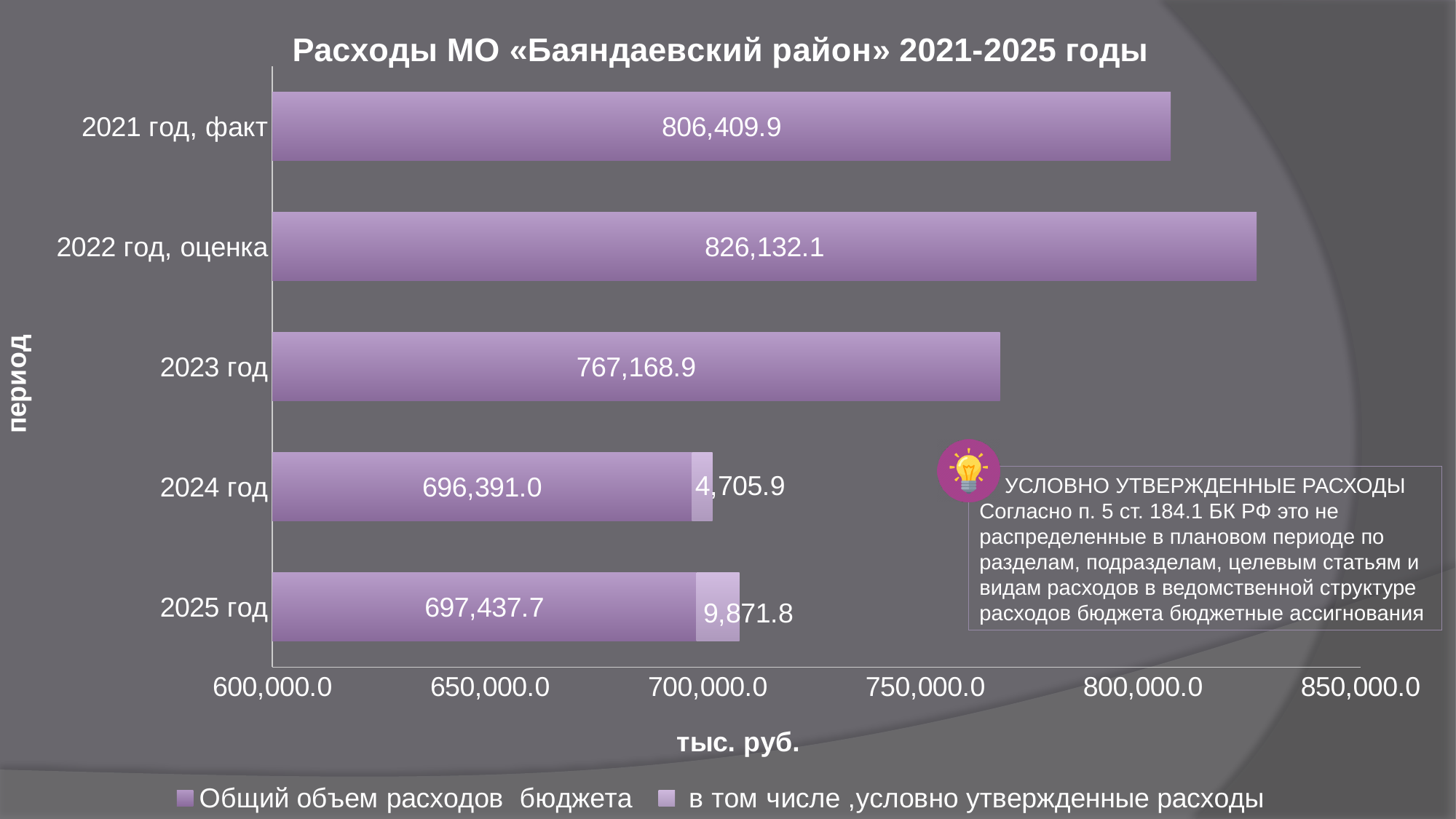
What is the total of the stacked bar for «2025 год»? 707,309.5 Is «Общий объем расходов бюджета» larger for «2023 год» or for «2025 год»? 2023 год How many series does the legend list? 2 What is the difference between «Общий объем расходов бюджета» for «2022 год, оценка» and for «2021 год, факт»? 19,722.2 What is the value of «в том числе ,условно утвержденные расходы» for «2025 год»? 9,871.8 How many periods are shown on the chart? 5 Which period has the lowest value of «Общий объем расходов бюджета»? 2024 год What is the value of «Общий объем расходов бюджета» for «2022 год, оценка»? 826,132.1 Which period has the highest value of «Общий объем расходов бюджета»? 2022 год, оценка Is the value for «2023 год» greater or less than 750,000.0? greater What is the value of «Общий объем расходов бюджета» for «2021 год, факт»? 806,409.9 What is the value of «в том числе ,условно утвержденные расходы» for «2024 год»? 4,705.9